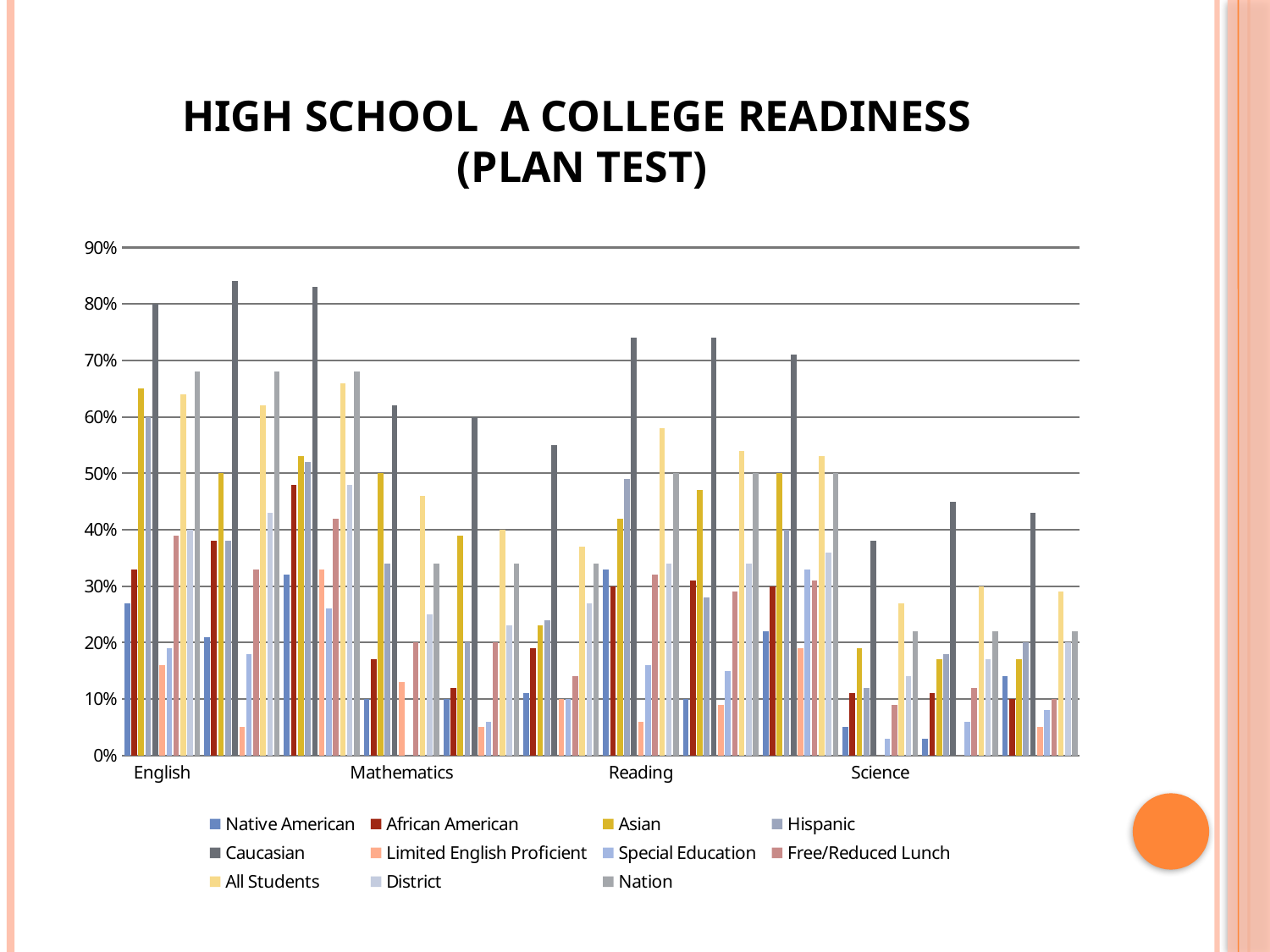
Which subject category has the lowest bars overall? Science Which is higher, the tallest Caucasian bar in English or the tallest Caucasian bar in Science? English What is the title of the chart? HIGH SCHOOL A COLLEGE READINESS (PLAN TEST) How many series does the legend list? 11 Is the tallest bar in the Science group greater or less than 50%? less Which series has the tallest bar anywhere in the chart? Caucasian How many subject categories are labelled on the x axis? 4 Do the Caucasian bars generally rise or fall moving from English to Science along the x axis? fall Is the tallest bar in the English group greater or less than 80%? greater Which series is shown in dark grey in the legend? Caucasian What kind of chart is shown on the slide? bar chart